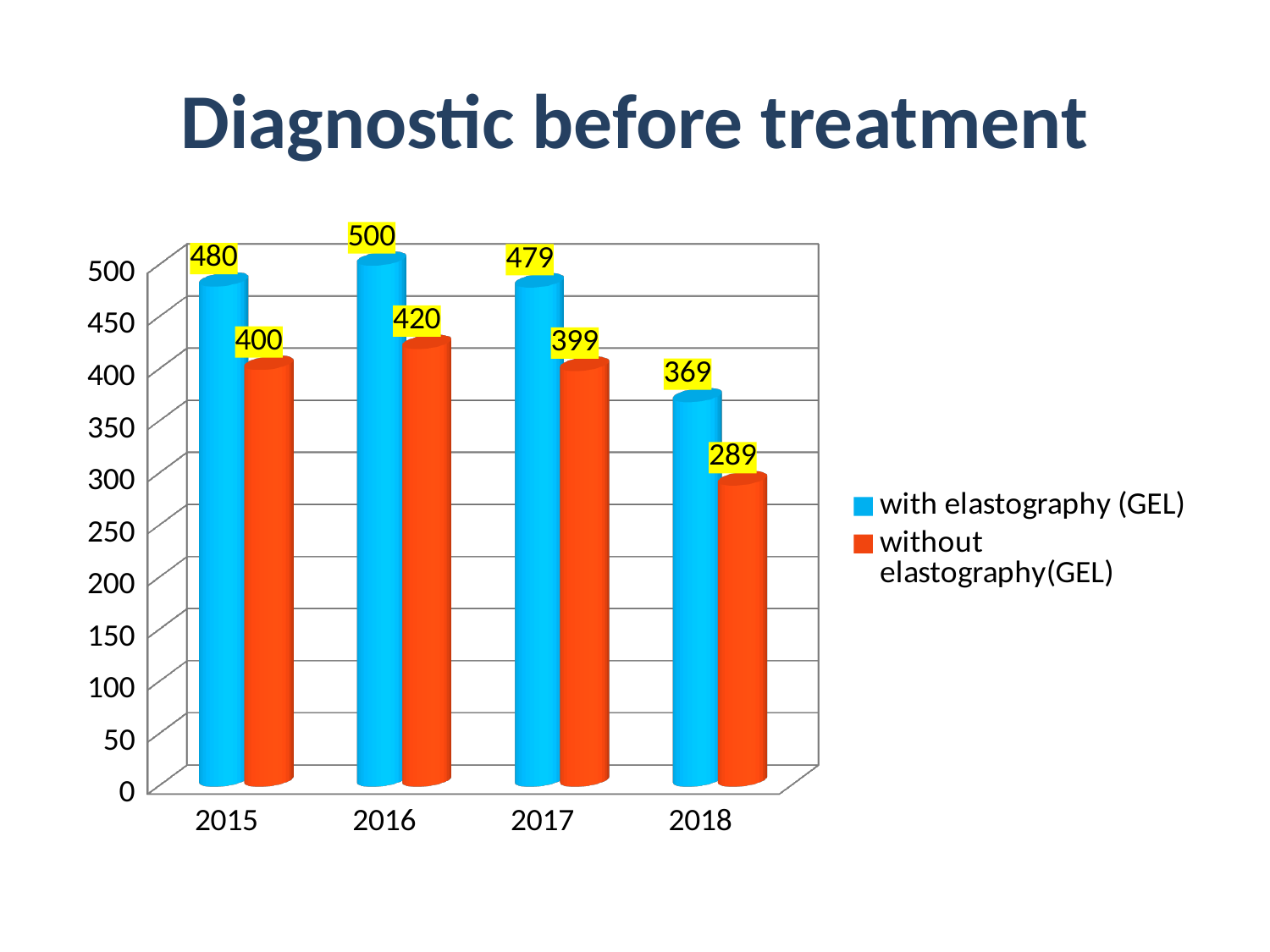
How many years are shown on the x axis? 4 What is the difference between 'with elastography (GEL)' and 'without elastography(GEL)' in 2017? 80 Which year has the lowest value for 'without elastography(GEL)'? 2018 What is the value for 'without elastography(GEL)' in 2015? 400 What kind of chart is shown on the slide? bar chart What is the value for 'without elastography(GEL)' in 2018? 289 How many series does the legend list? 2 What is the value for 'with elastography (GEL)' in 2016? 500 What is the title of the slide? Diagnostic before treatment Which is larger in 2018: 'with elastography (GEL)' or 'without elastography(GEL)'? with elastography (GEL) What is the difference between the 'with elastography (GEL)' values for 2016 and 2018? 131 Which year has the highest value for 'with elastography (GEL)'? 2016